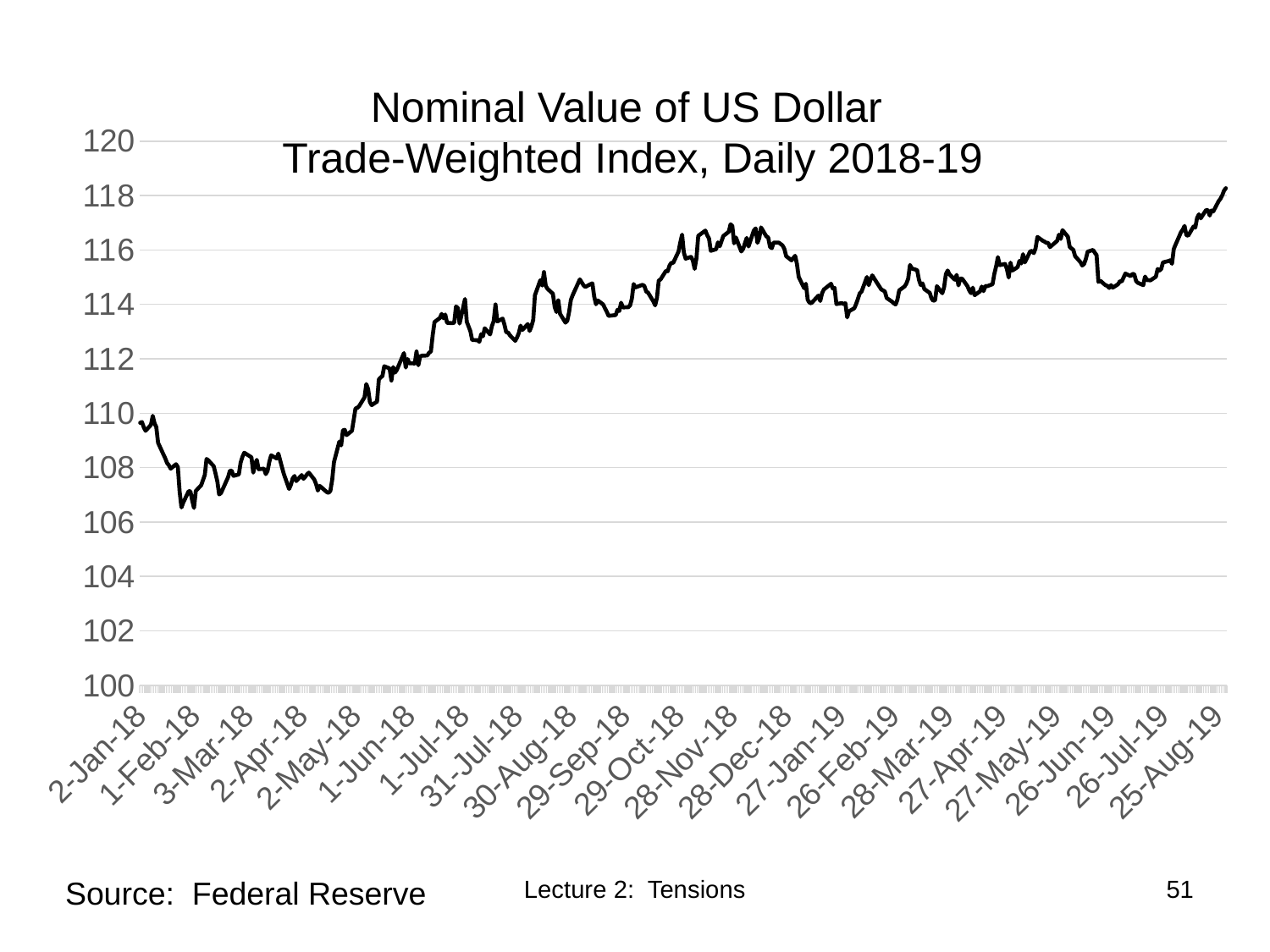
What kind of chart is shown on the slide? line chart Is the value of the index at 2-Jan-18 greater or less than 108? greater In which month does the index reach its highest point on the chart? August 2019 What source is cited for the chart's data? Federal Reserve Which is higher: the index value at 1-Feb-18 or at 1-Jun-18? 1-Jun-18 What is the title of the chart? Nominal Value of US Dollar Trade-Weighted Index, Daily 2018-19 Is the value of the index at the end of the series (late August 2019) greater or less than 116? greater Is the value of the index around 1-Feb-18 greater or less than 110? less Overall, does the index rise or fall from the start of the series in January 2018 to the end in August 2019? rise